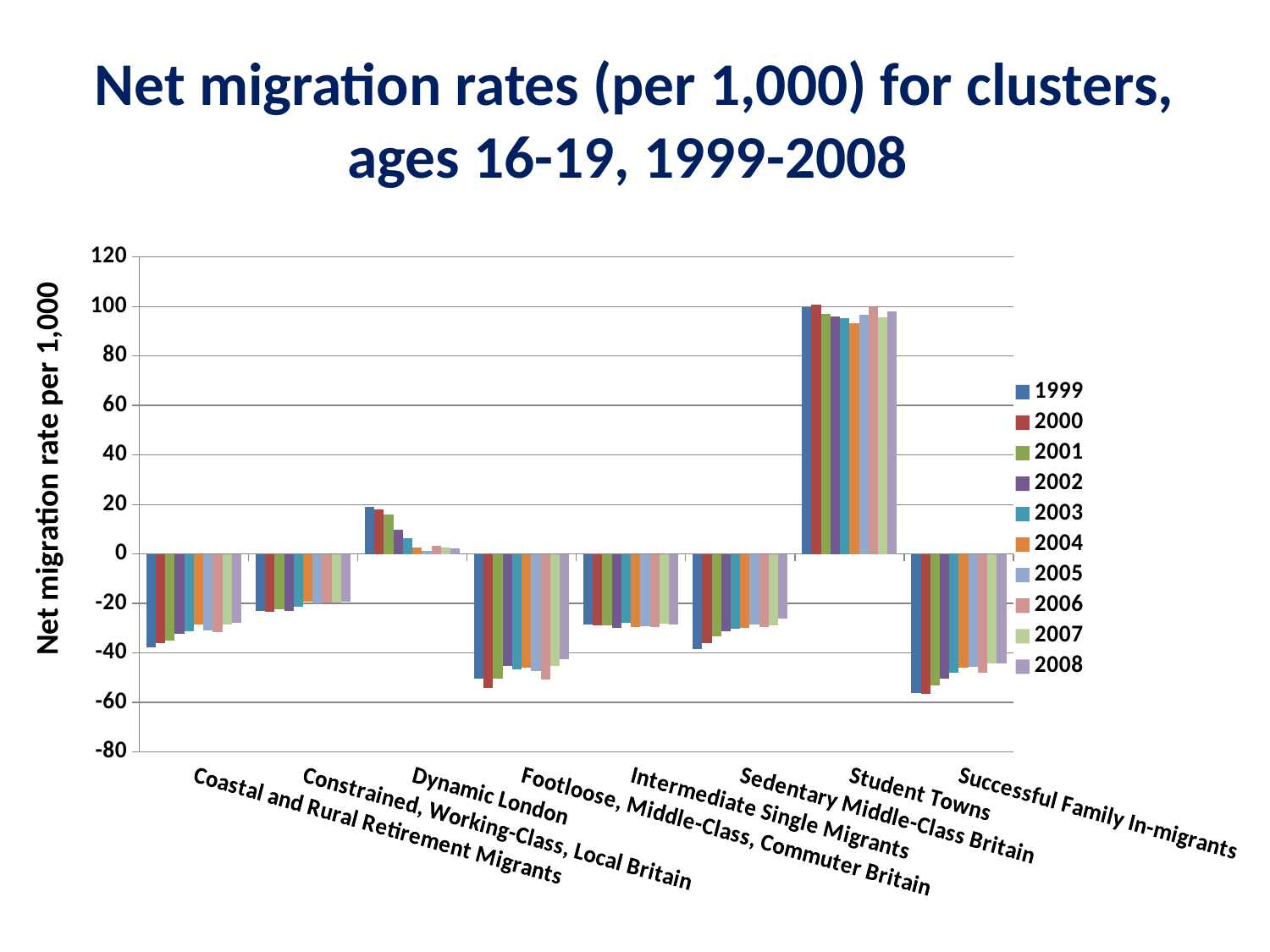
How many series (years) does the legend list? 10 Is the 1999 value for Student Towns greater or less than 80? greater Do the values for Successful Family In-migrants rise or fall from 1999 to 2008? Rise Do the values for Dynamic London rise or fall from 1999 to 2008? Fall Which cluster has the lowest net migration rate in 1999? Successful Family In-migrants How many clusters (categories) are shown along the x axis? 8 Which is larger in 1999: the value for Constrained, Working-Class, Local Britain or the value for Coastal and Rural Retirement Migrants? Constrained, Working-Class, Local Britain What is the title of the vertical axis? Net migration rate per 1,000 Is the 1999 value for Dynamic London greater or less than 0? greater What kind of chart is shown on the slide? Bar chart Which cluster has the highest net migration rate for ages 16-19? Student Towns Is the 1999 value for Coastal and Rural Retirement Migrants greater or less than -20? less